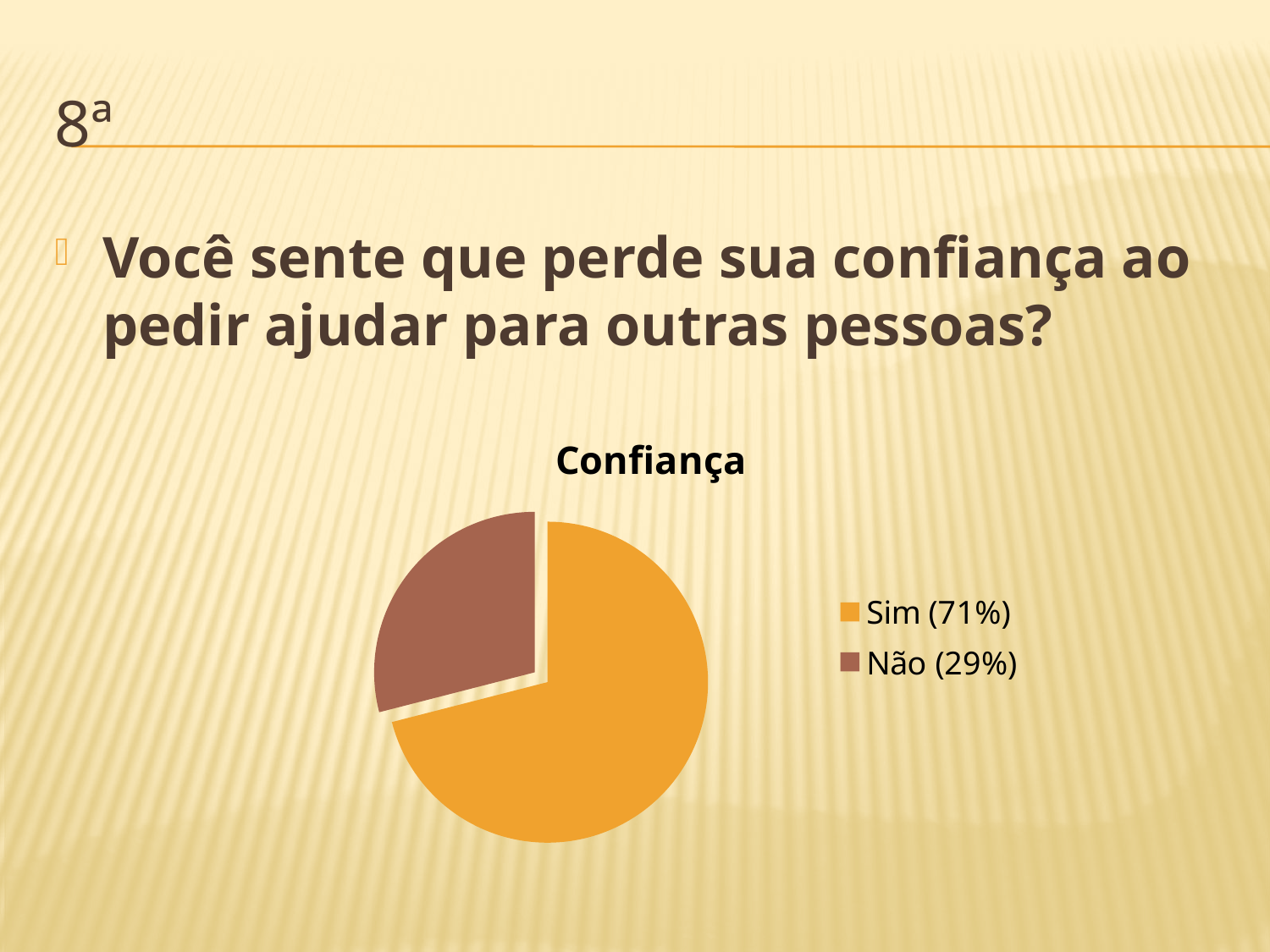
What share of the pie does the "Não" slice represent? 29% How many slices does the pie chart have? 2 Which slice of the pie is the largest? Sim (71%) What is the difference in percentage points between the "Sim" and "Não" slices? 42 What share of the pie does the "Sim" slice represent? 71% Which slice of the pie is the smallest? Não (29%) How many entries does the legend list? 2 What colour is the "Não" slice in the pie chart? brown What kind of chart is shown on the slide? pie chart Which is larger, the "Sim" slice or the "Não" slice? Sim What is the title of the chart? Confiança